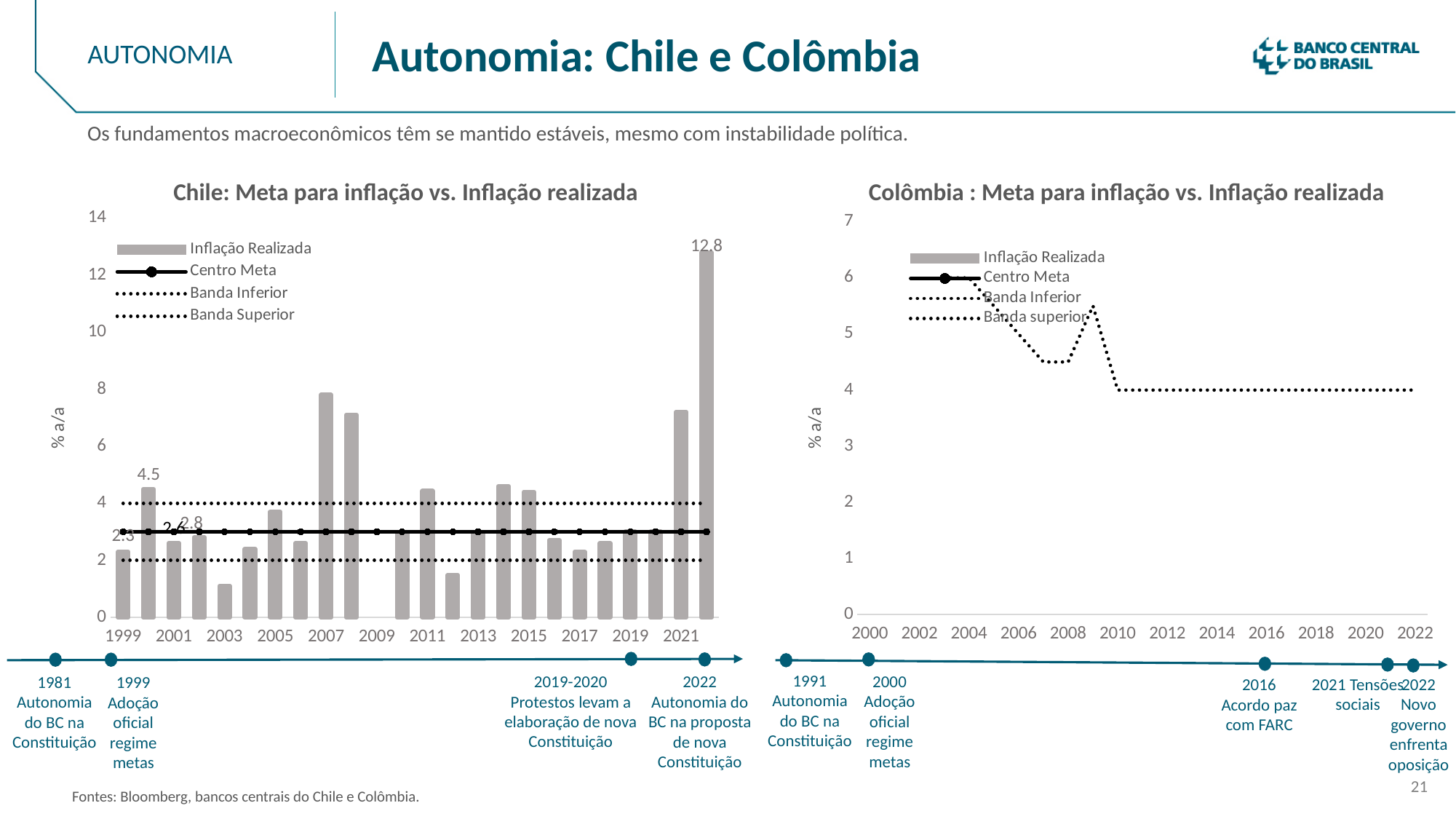
In the Chile chart, what is the value of Inflação Realizada for 2000? 4.5 How many series does the legend of the Chile chart list? 4 How many series does the legend of the Colômbia chart list? 4 In the Chile chart, which year has the highest Inflação Realizada bar? 2022 In the Chile chart, is the Inflação Realizada bar for 2012 greater or less than 2? less In the Chile chart, what is the difference between the Inflação Realizada values for 2022 and 2000? 8.3 What kind of chart is used for Inflação Realizada in the Chile chart? Bar chart In the Chile chart, is the Inflação Realizada bar for 2007 greater or less than 6? greater In the Chile chart, what is the value of Inflação Realizada for 2022? 12,8 What is the title of the chart on the right side of the slide? Colômbia : Meta para inflação vs. Inflação realizada In the Chile chart, which year has a higher Inflação Realizada bar, 2007 or 2008? 2007